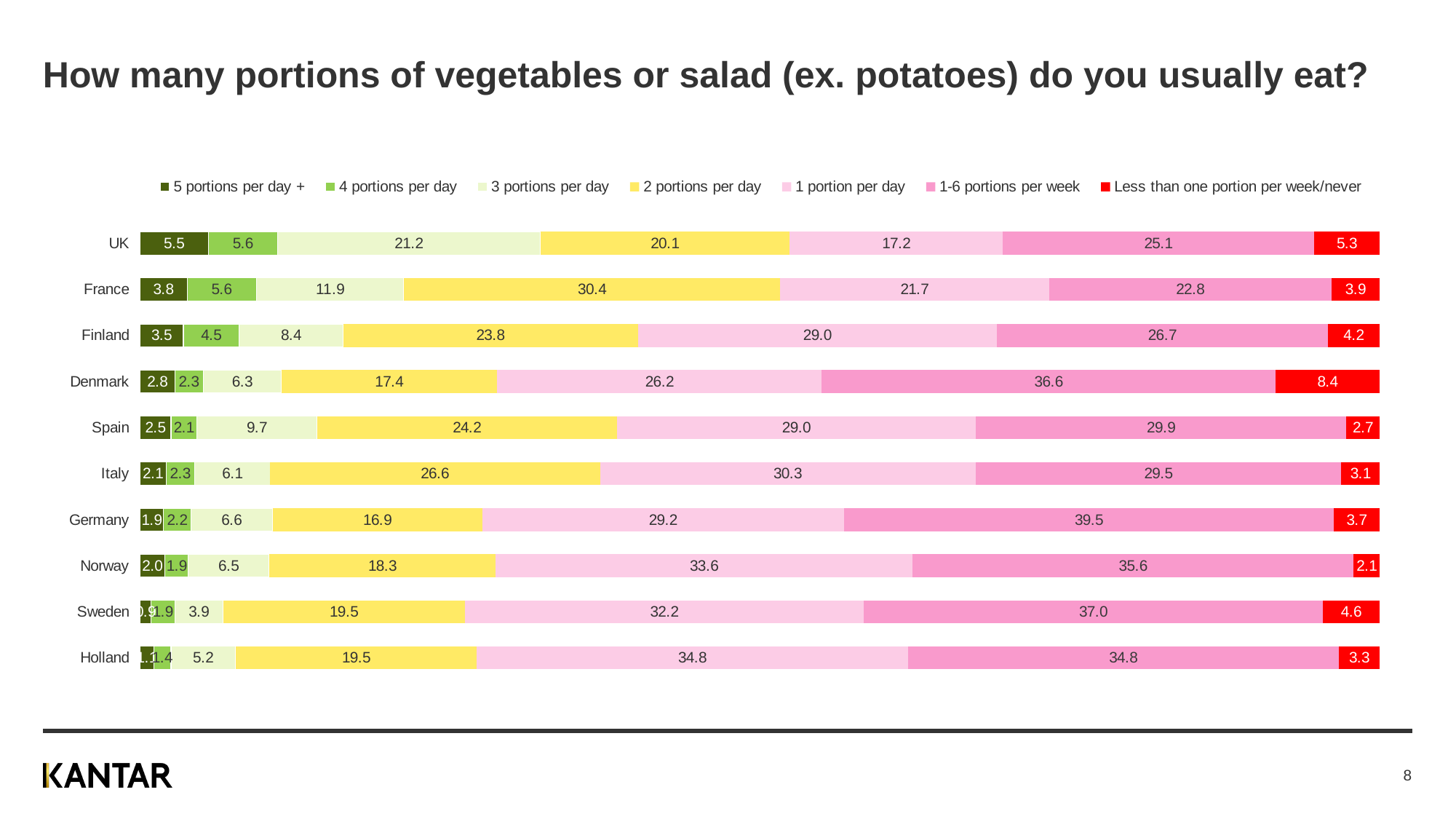
What is the value for '1-6 portions per week' for Germany? 39.5 What is the difference between France's and the UK's values for '2 portions per day'? 10.3 Which country has the lowest value for 'Less than one portion per week/never'? Norway Which country has the highest value for '2 portions per day'? France How many series does the legend list? 7 What is the value for '1 portion per day' for Holland? 34.8 Which country has the highest value for '1-6 portions per week'? Germany What kind of chart is shown on the slide? Stacked bar chart How many countries are shown in the chart? 10 What is the value for '5 portions per day +' for the UK? 5.5 Which is larger for 'Less than one portion per week/never': Denmark or Finland? Denmark What colour represents 'Less than one portion per week/never' in the chart? Red